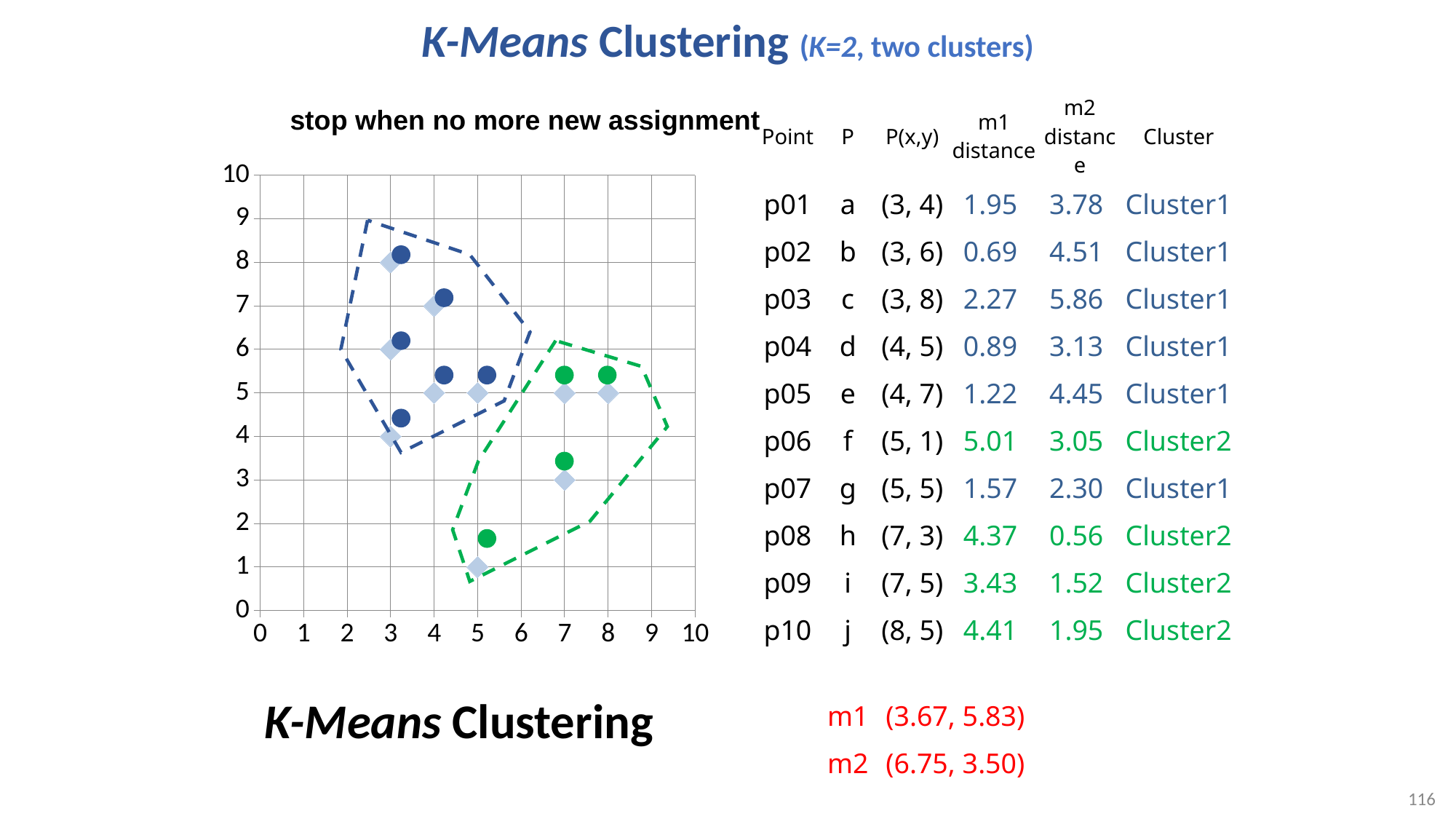
What is the highest value shown on the chart's y axis? 10 How many data points are enclosed by the green dashed outline on the chart? 4 What are the coordinates of the point with the highest y value on the chart? (3, 8) How many data points are enclosed by the blue dashed outline on the chart? 6 What are the coordinates of the point with the largest x value on the chart? (8, 5) According to the table, what is the m1 distance for point p02 (b)? 0.69 Is the y value of the point at x = 8 greater or less than 4? greater What are the coordinates of the point with the lowest y value on the chart? (5, 1) What is the title printed above the chart? stop when no more new assignment Which cluster is point p07 (g) at (5, 5) assigned to in the table? Cluster1 How many light-blue diamond data points are plotted on the chart? 10 What kind of chart is shown on the slide? scatter chart